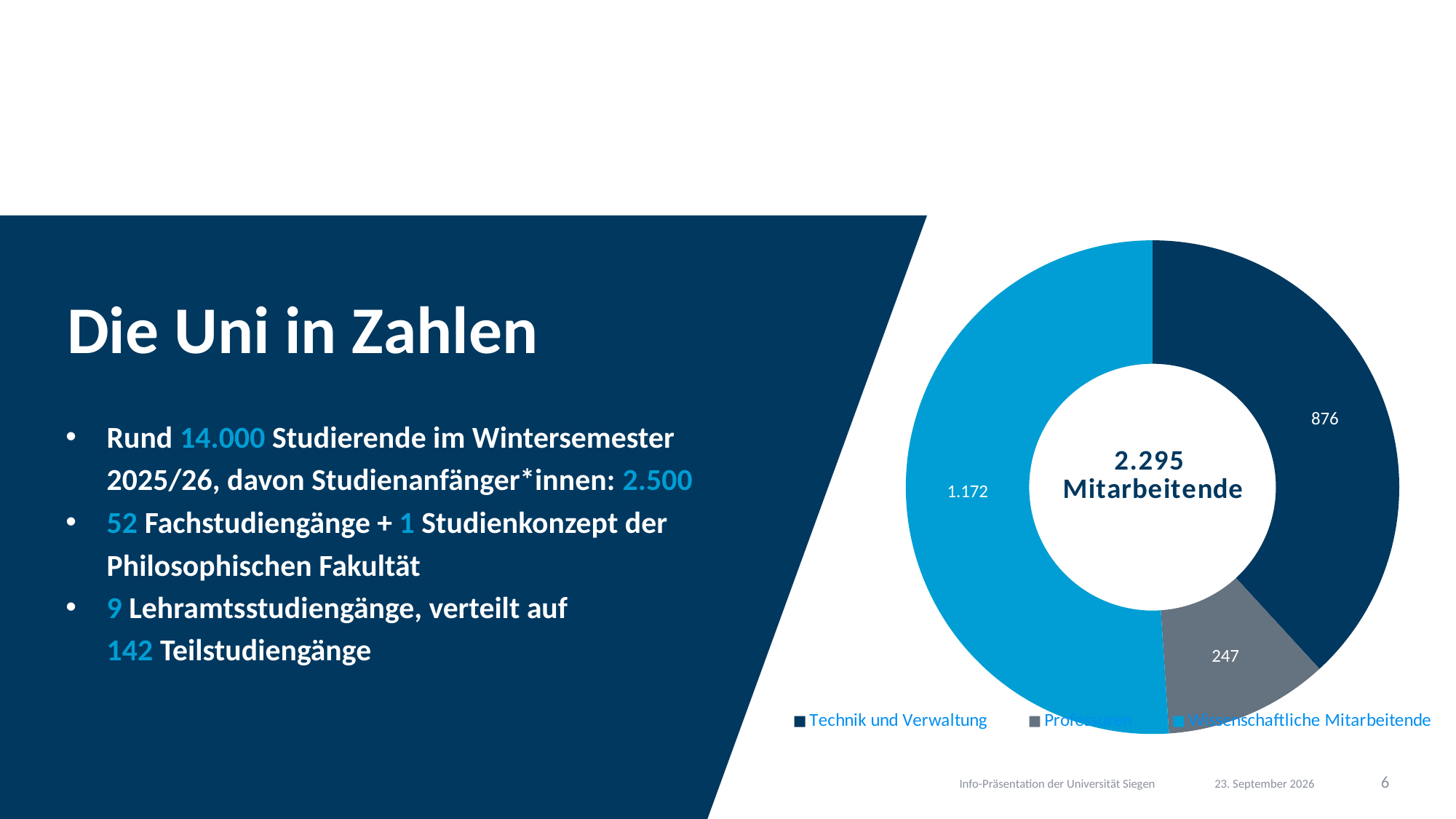
How many categories does the donut chart show? 3 Which category has the largest slice in the donut chart? Wissenschaftliche Mitarbeitende Which colour represents Professuren in the donut chart? Grey Which is larger, the value for Technik und Verwaltung or the value for Professuren? Technik und Verwaltung What is the value for Wissenschaftliche Mitarbeitende in the donut chart? 1.172 What total number of employees is shown in the centre of the donut chart? 2.295 Mitarbeitende Which category has the smallest slice in the donut chart? Professuren What is the difference between the values for Technik und Verwaltung and Professuren? 629 What kind of chart is shown on the slide? Donut (pie) chart What is the difference between the values for Wissenschaftliche Mitarbeitende and Technik und Verwaltung? 296 What is the value for Professuren in the donut chart? 247 What is the value for Technik und Verwaltung in the donut chart? 876